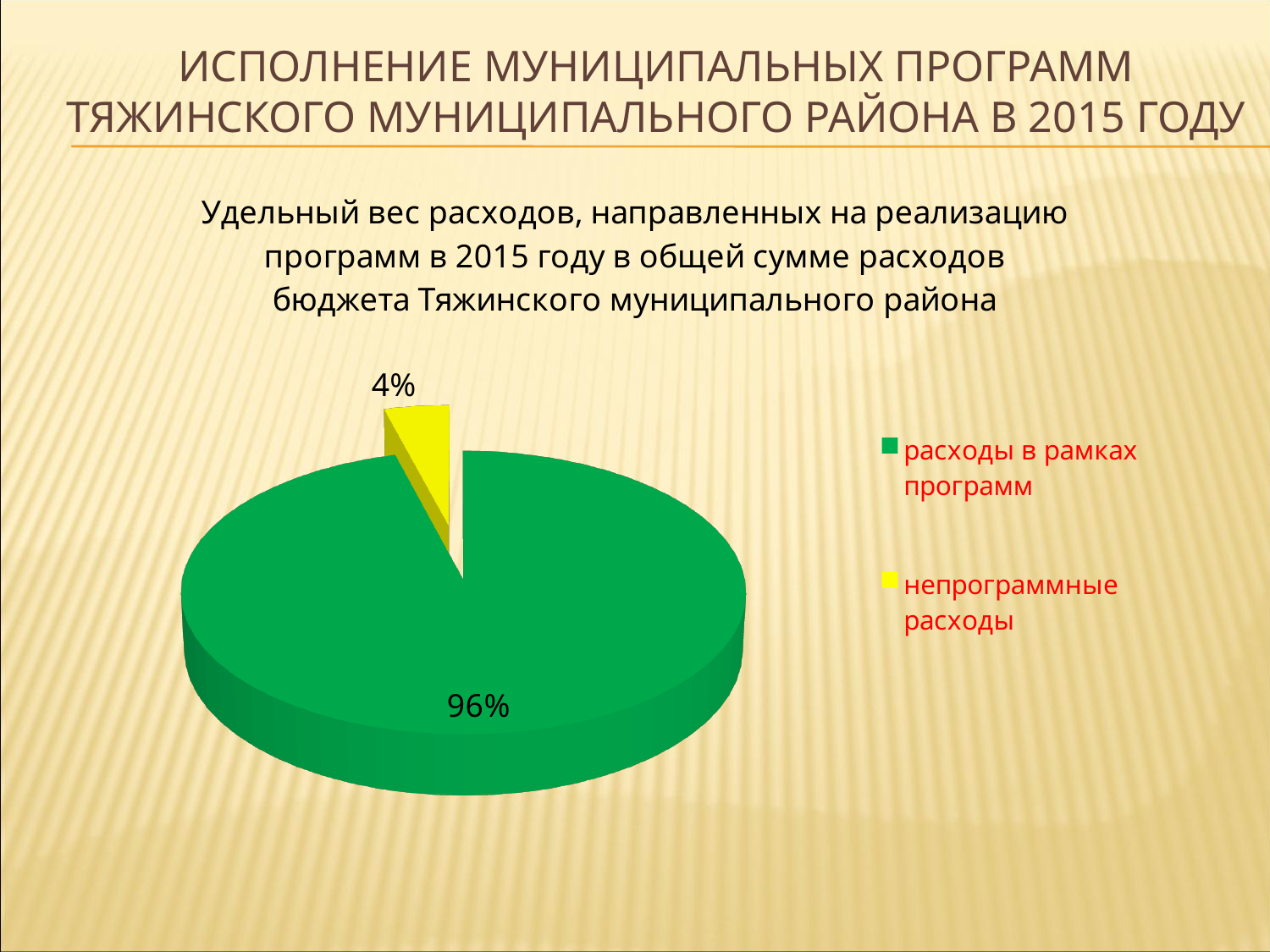
How many entries does the legend list? 2 Which slice of the pie is the smallest? непрограммные расходы Which slice of the pie is the largest? расходы в рамках программ What colour is the slice for "непрограммные расходы"? yellow What share of the pie is labelled "непрограммные расходы"? 4% What colour is the slice for "расходы в рамках программ"? green What share of the pie is labelled "расходы в рамках программ"? 96% What is the difference between the shares of "расходы в рамках программ" and "непрограммные расходы"? 92% What kind of chart is shown on the slide? pie chart Which is larger: the share of "расходы в рамках программ" or the share of "непрограммные расходы"? расходы в рамках программ How many slices does the pie chart have? 2